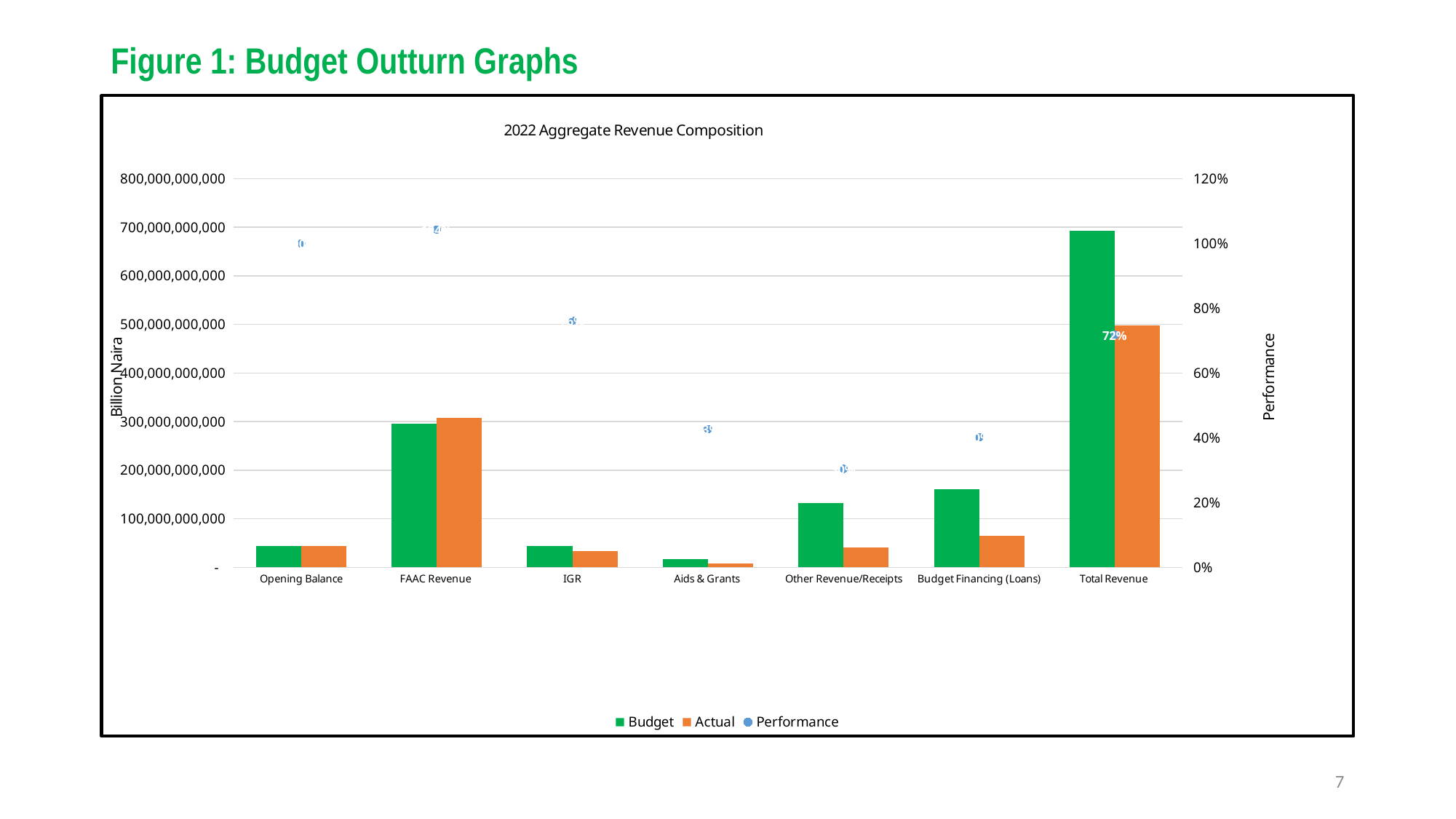
Is the Budget value for Budget Financing (Loans) greater or less than 100,000,000,000? greater What kind of chart is shown on the slide? bar chart Which category has the lowest Actual value? Aids & Grants What is the Performance value labelled for Total Revenue? 72% What is the title of the chart? 2022 Aggregate Revenue Composition What is the label of the right-hand (secondary) vertical axis? Performance Which category has the highest Budget value? Total Revenue Is the Budget value for Total Revenue greater or less than 600,000,000,000? greater How many series does the legend list? 3 How many categories are shown on the x axis? 7 For Total Revenue, which is larger, the Budget or the Actual value? Budget Is the Budget value for Aids & Grants greater or less than 100,000,000,000? less